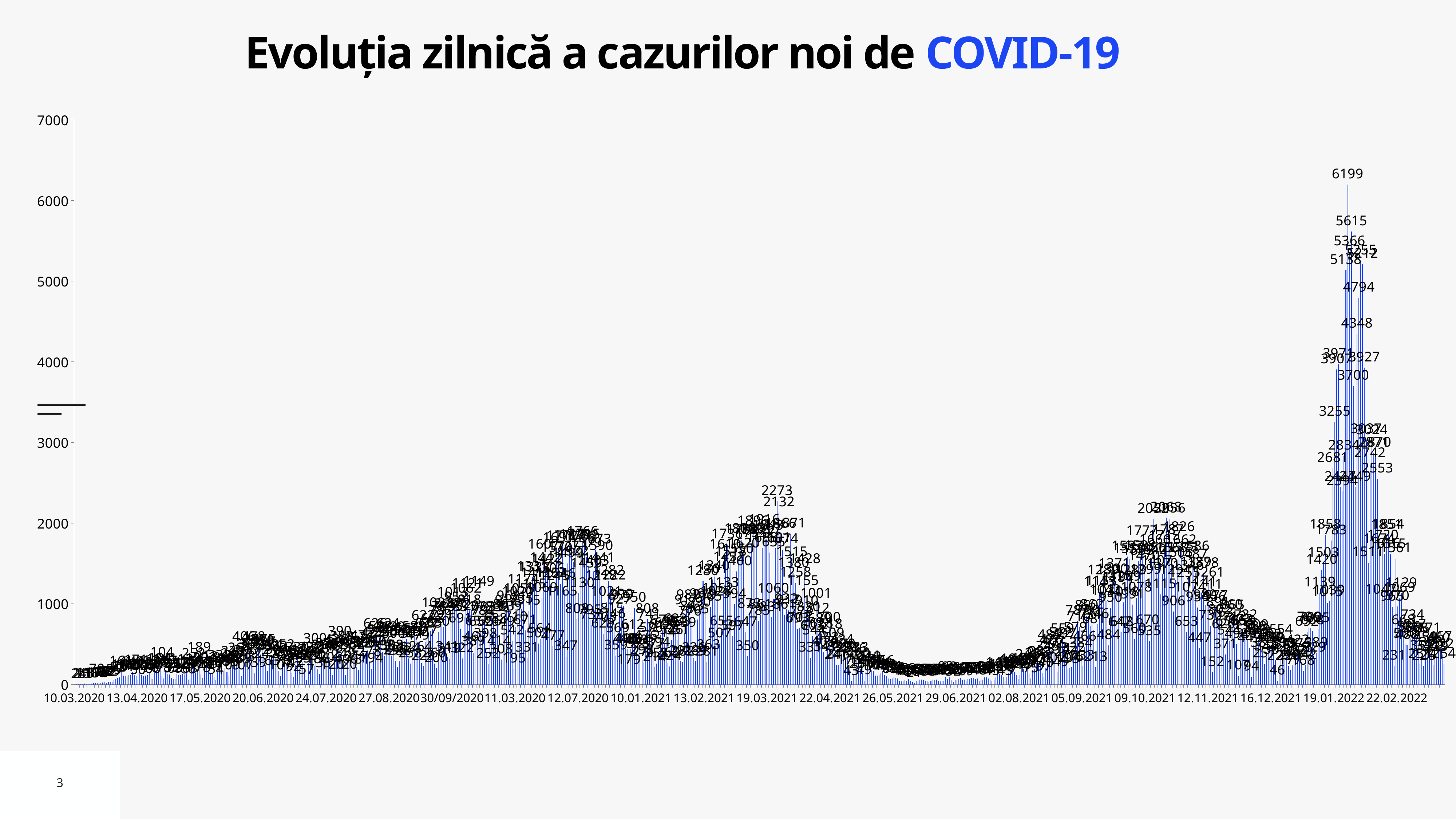
What is the highest tick value shown on the vertical axis? 7000 Are the values around 26.05.2021 greater or less than 1000? less What is the highest value labelled on the chart? 6199 What is the last date label on the horizontal axis? 22.02.2022 Is the highest value in the peak around 19.03.2021 greater or less than 2000? greater Which peak is higher: the one around 19.01.2022 or the one around 19.03.2021? the one around 19.01.2022 What is the first date label on the horizontal axis? 10.03.2020 What is the title of the chart? Evoluția zilnică a cazurilor noi de COVID-19 What is the difference between the highest labelled value (6199) and the second highest labelled value (5615)? 584 What kind of chart is shown on the slide? bar chart Do the values rise or fall between 02.08.2021 and 09.10.2021? rise